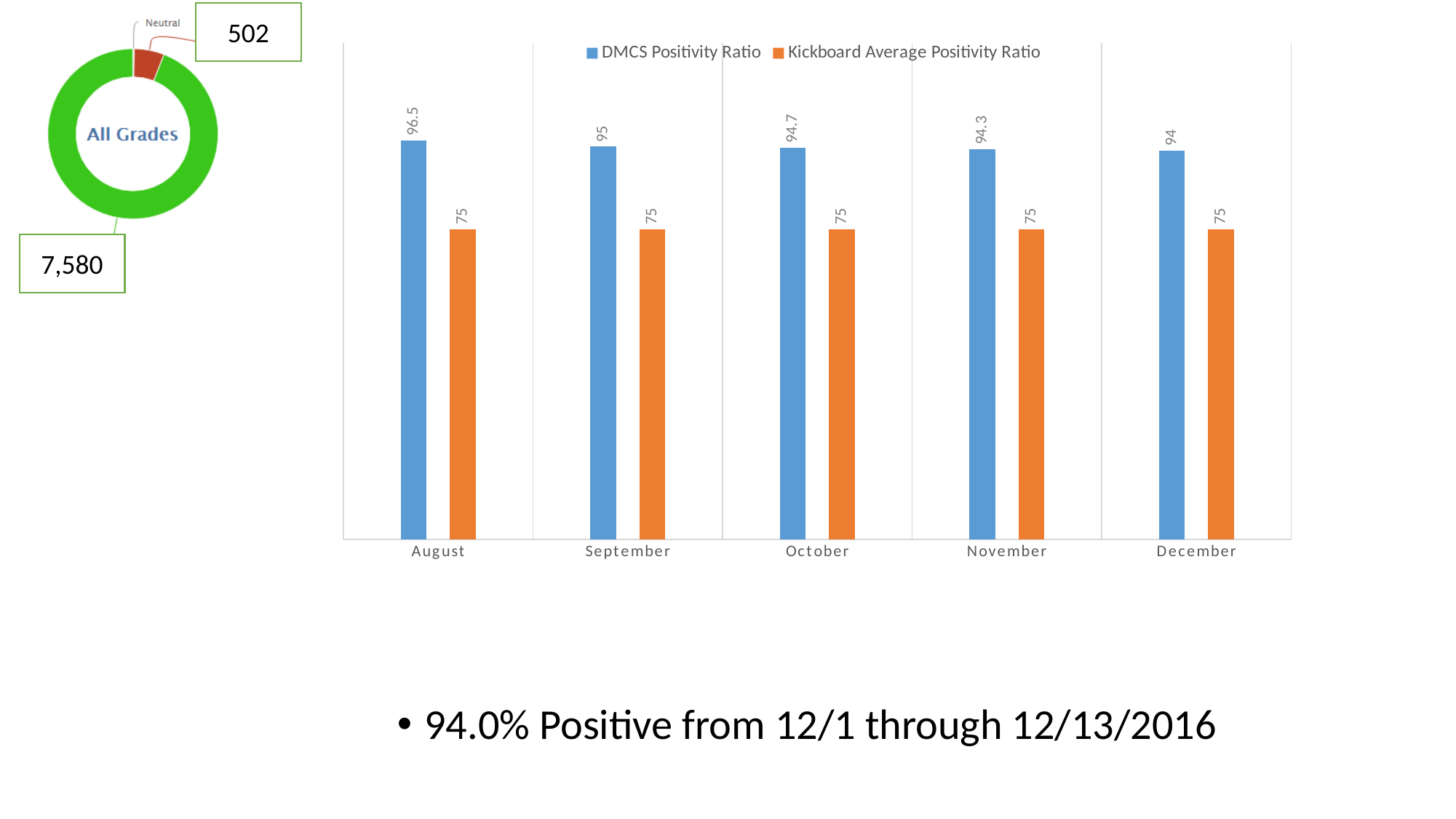
How many series does the legend of the bar chart list? 2 What kind of chart is the chart on the right of the slide? bar chart How many months are shown on the x axis of the bar chart? 5 In the bar chart, what is the DMCS Positivity Ratio for October? 94.7 In the bar chart, what is the difference between the DMCS Positivity Ratio and the Kickboard Average Positivity Ratio in September? 20 In the All Grades donut chart, what is the value of the Neutral slice? 502 In the bar chart, which is larger in December: the DMCS Positivity Ratio or the Kickboard Average Positivity Ratio? DMCS Positivity Ratio In the bar chart, what is the Kickboard Average Positivity Ratio for November? 75 Does the DMCS Positivity Ratio rise or fall from August to December in the bar chart? fall In the bar chart, which month has the lowest DMCS Positivity Ratio? December In the bar chart, which month has the highest DMCS Positivity Ratio? August In the bar chart, what is the DMCS Positivity Ratio for August? 96.5